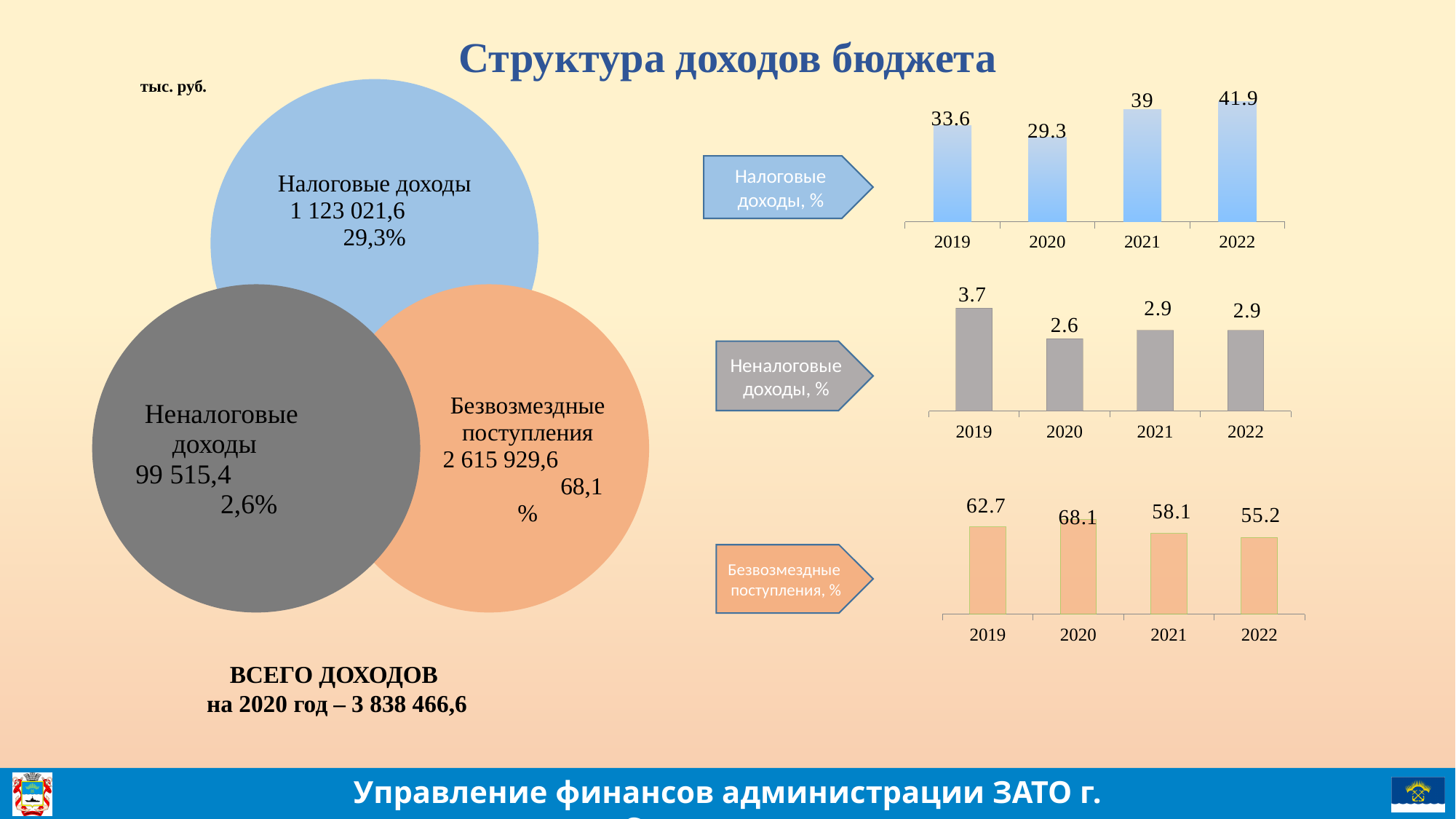
What type of chart is the 'Налоговые доходы, %' chart? bar chart In the 'Безвозмездные поступления, %' chart, what is the value for 2020? 68.1 In the 'Налоговые доходы, %' chart, which year has the lowest value? 2020 In the 'Безвозмездные поступления, %' chart, which year has the lowest value? 2022 In the 'Налоговые доходы, %' chart, what is the value for 2022? 41.9 In the 'Неналоговые доходы, %' chart, what is the value for 2019? 3.7 In the 'Неналоговые доходы, %' chart, how many years are shown on the x axis? 4 In the 'Налоговые доходы, %' chart, what is the difference between the values for 2022 and 2019? 8.3 In the 'Безвозмездные поступления, %' chart, what is the difference between the values for 2020 and 2022? 12.9 In the 'Неналоговые доходы, %' chart, which year has the highest value? 2019 In the 'Безвозмездные поступления, %' chart, which is larger, the value for 2019 or the value for 2021? 2019 In the 'Безвозмездные поступления, %' chart, do the values rise or fall from 2020 to 2022? fall